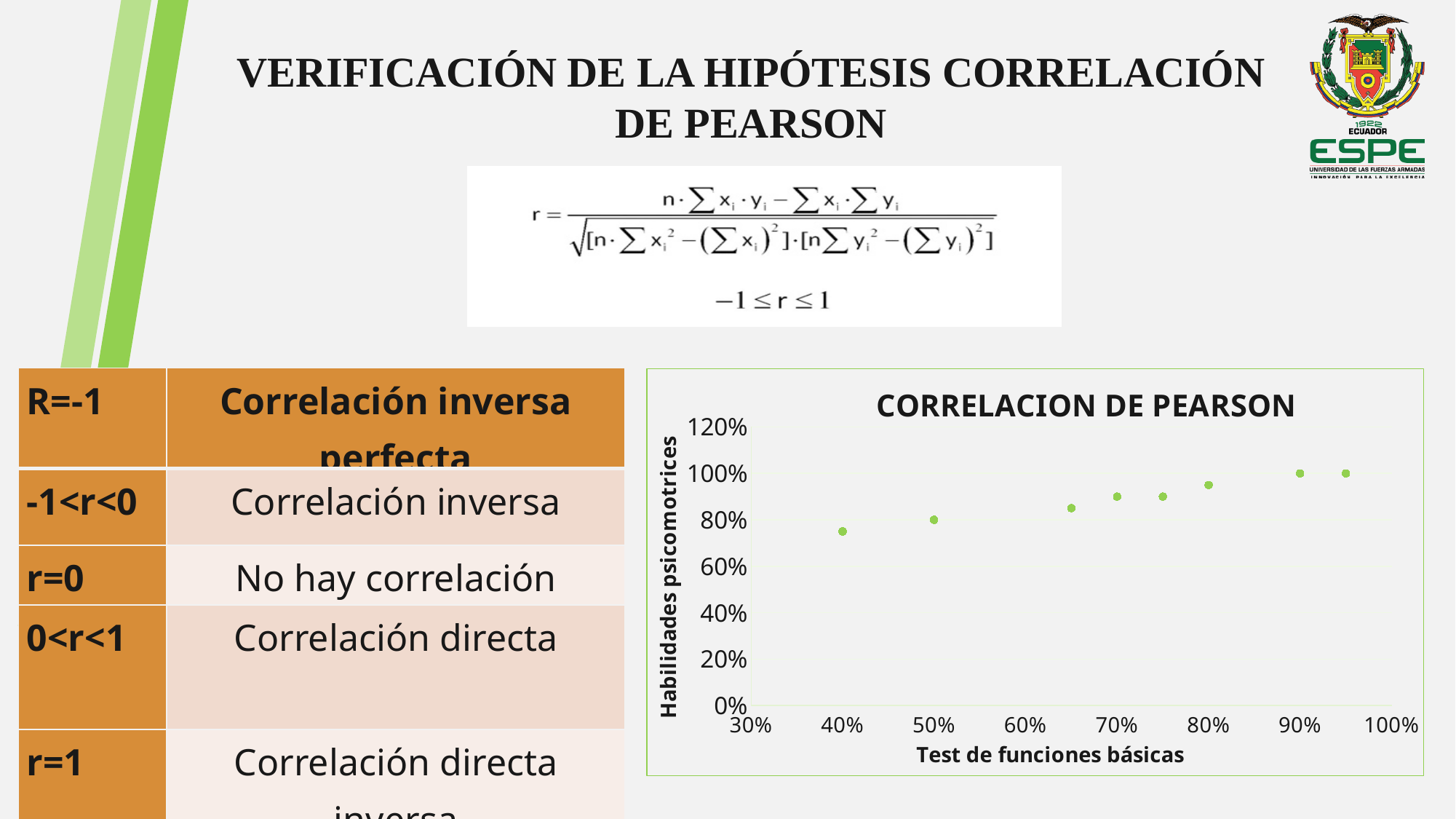
Which point has the lowest Habilidades psicomotrices value in the chart? The point at 40% on the x axis Which has the higher Habilidades psicomotrices value: the point at 40% or the point at 90% on the x axis? The point at 90% What kind of chart is shown on the slide? Scatter chart Is the Habilidades psicomotrices value for the point at 40% on the x axis greater or less than 60%? greater What is the label of the x axis of the chart? Test de funciones básicas Is the Habilidades psicomotrices value for the point at 40% on the x axis greater or less than 80%? less Do the values of Habilidades psicomotrices rise or fall as Test de funciones básicas increases along the x axis? Rise Is the Habilidades psicomotrices value for the point at 70% on the x axis greater or less than 80%? greater What is the title of the chart on the slide? CORRELACION DE PEARSON What is the highest value shown on the y axis of the chart? 120%